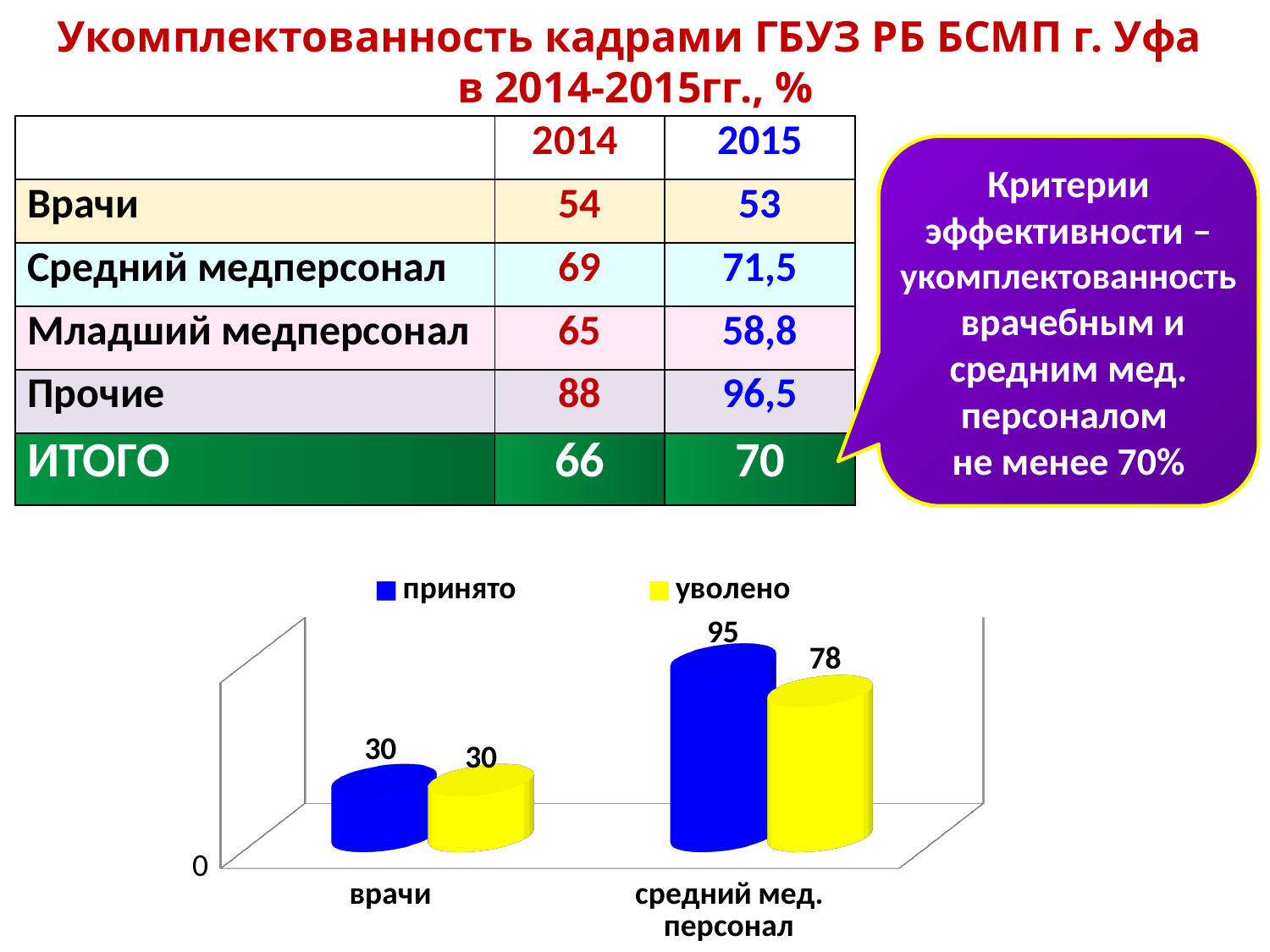
In the chart, what is the value for принято for средний мед. персонал? 95 In the chart, what is the value for принято for врачи? 30 In the chart, what is the difference between принято for средний мед. персонал and принято for врачи? 65 In the chart, which category has the highest value for принято? средний мед. персонал How many categories are shown on the x axis of the chart? 2 In the chart, what is the difference between принято and уволено for средний мед. персонал? 17 What kind of chart is shown at the bottom of the slide? bar chart In the chart, which is larger for средний мед. персонал: принято or уволено? принято How many series does the chart's legend list? 2 In the chart, what is the value for уволено for врачи? 30 In the chart, which category has the lowest value for уволено? врачи In the chart, what is the value for уволено for средний мед. персонал? 78